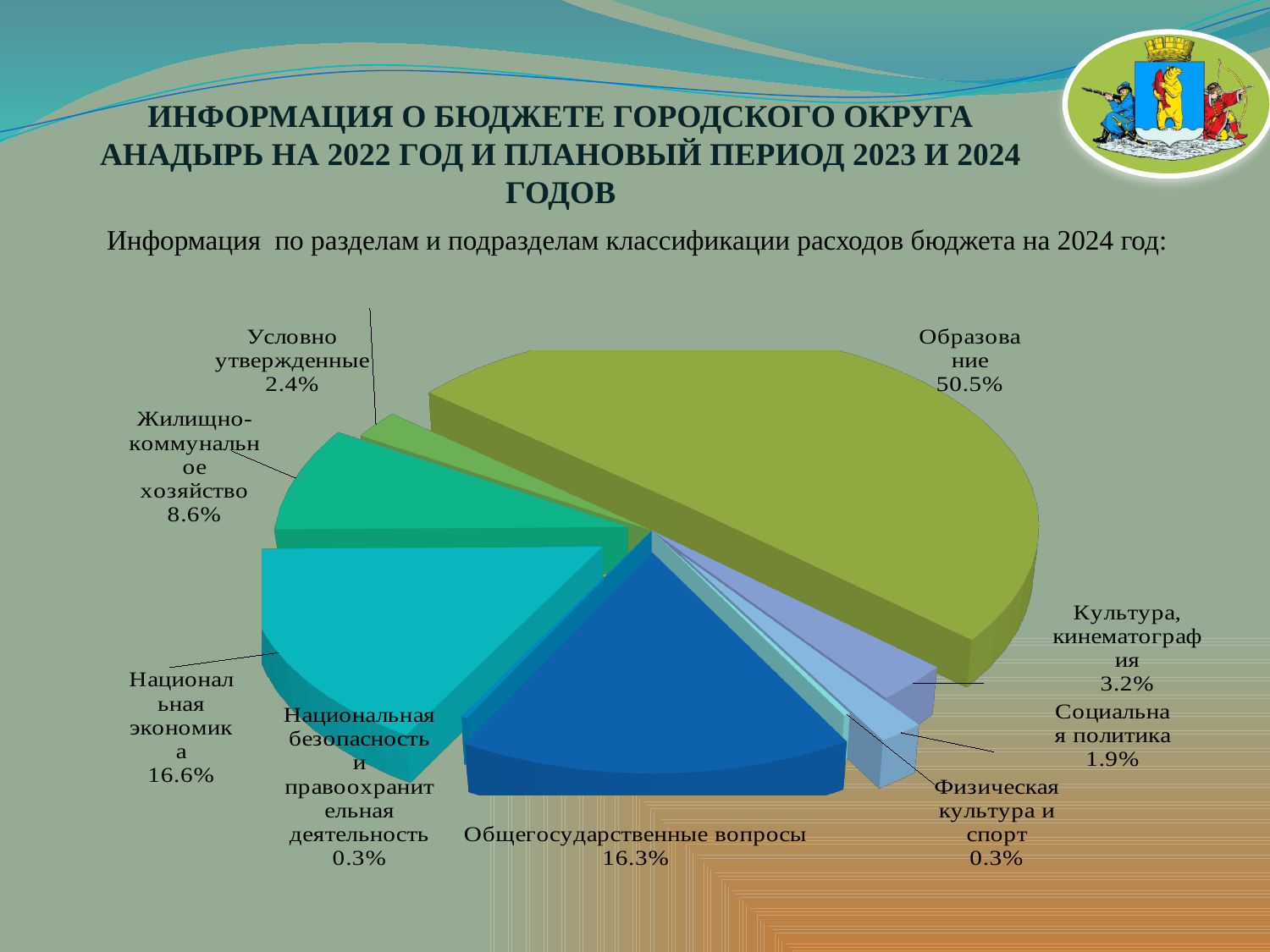
What share of the 2024 budget expenditure goes to Образование? 50.5% What kind of chart is shown on the slide? Pie chart What is the difference in percentage points between Образование and Национальная экономика? 33.9 Which is larger: Культура, кинематография or Условно утвержденные? Культура, кинематография How many sections are shown in the pie chart? 9 What percentage is shown for Общегосударственные вопросы? 16.3% What is the combined share of Национальная экономика and Общегосударственные вопросы? 32.9% Which two sections each have the smallest share, 0.3%? Национальная безопасность и правоохранительная деятельность; Физическая культура и спорт What percentage is shown for Социальная политика? 1.9% What percentage is shown for Жилищно-коммунальное хозяйство? 8.6% What percentage is shown for Национальная экономика? 16.6% Which section has the largest share of the pie? Образование